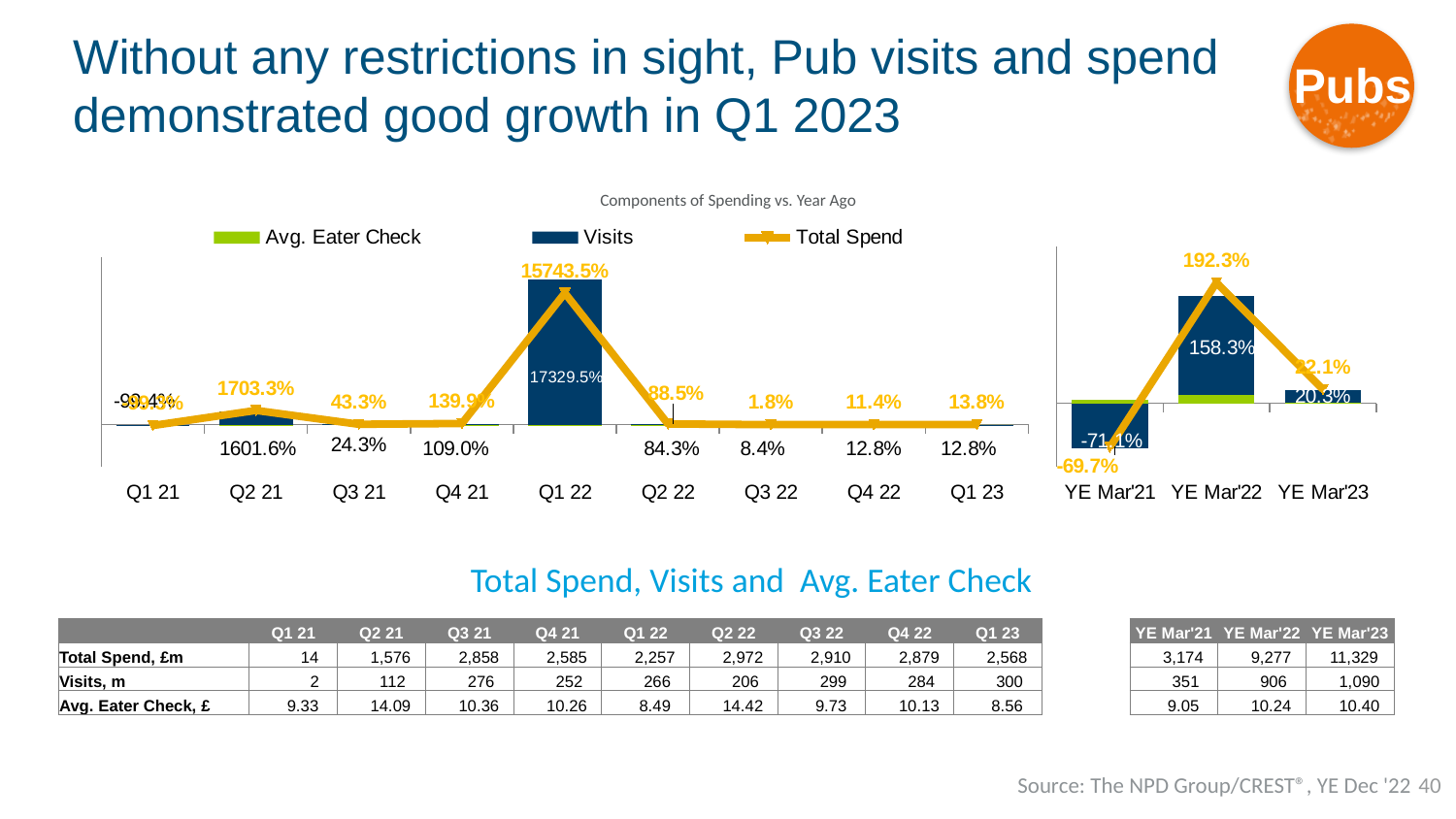
On the right chart (YE Mar'21 to YE Mar'23), what is the Total Spend value for YE Mar'21? -69.7% On the left chart (Components of Spending vs. Year Ago), what is the Total Spend value for Q1 23? 13.8% On the left chart (Components of Spending vs. Year Ago), how many series does the legend list? 3 On the left chart (Components of Spending vs. Year Ago), in which quarter is the Total Spend value highest? Q1 22 What kind of chart is the left chart (Components of Spending vs. Year Ago)? bar and line chart On the left chart (Components of Spending vs. Year Ago), what is the Total Spend value for Q2 21? 1703.3% On the left chart (Components of Spending vs. Year Ago), what is the Visits value for Q1 22? 17329.5% On the right chart (YE Mar'21 to YE Mar'23), what is the Visits value for YE Mar'22? 158.3% On the left chart (Components of Spending vs. Year Ago), does the Total Spend value rise or fall from Q3 22 to Q1 23? rise On the left chart (Components of Spending vs. Year Ago), what is the difference between the Total Spend values for Q1 23 and Q4 22? 2.4 percentage points On the left chart (Components of Spending vs. Year Ago), which is larger, the Total Spend value for Q3 21 or for Q4 21? Q4 21 On the left chart (Components of Spending vs. Year Ago), how many quarters are shown on the x axis? 9